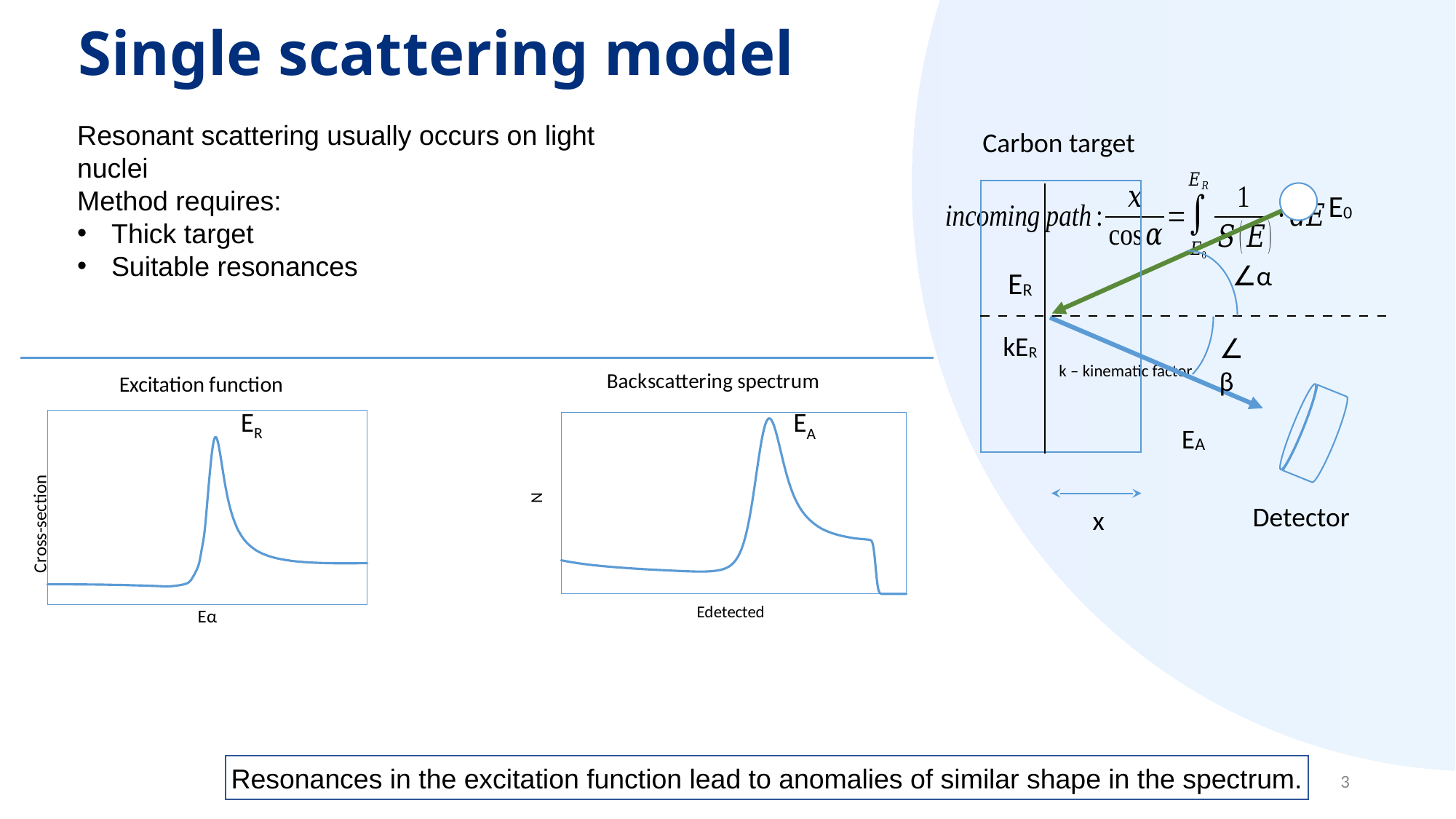
In the Excitation function chart, does the curve rise or fall as it approaches the peak from the left? rise In the Backscattering spectrum chart, does the curve rise or fall just after its peak? fall How many charts are shown on the slide? 2 In the Backscattering spectrum chart, does the curve rise or fall at the far right end of the x axis? fall How many lines are plotted in the Excitation function chart? 1 What label marks the peak in the Backscattering spectrum chart? EA What kind of chart is the Excitation function chart? line chart How many lines are plotted in the Backscattering spectrum chart? 1 What is the y-axis label of the Excitation function chart? Cross-section What kind of chart is the Backscattering spectrum chart? line chart